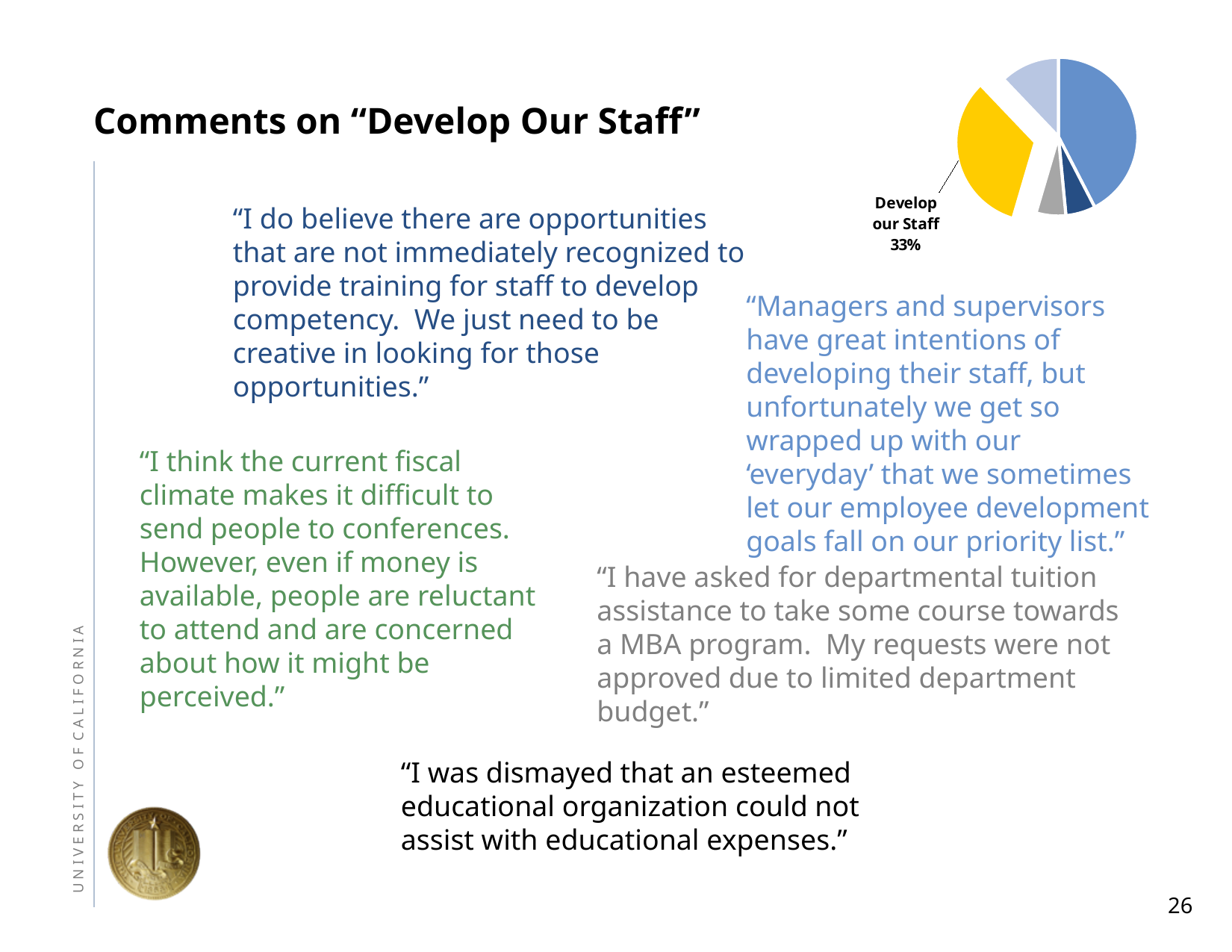
Which slice of the pie chart is labeled on the slide? Develop our Staff What colour is the "Develop our Staff" slice in the pie chart? yellow What kind of chart is shown in the top-right corner of the slide? pie chart What is the value printed for the "Develop our Staff" slice of the pie chart? 33% What share of the pie chart does the "Develop our Staff" slice represent? 33%